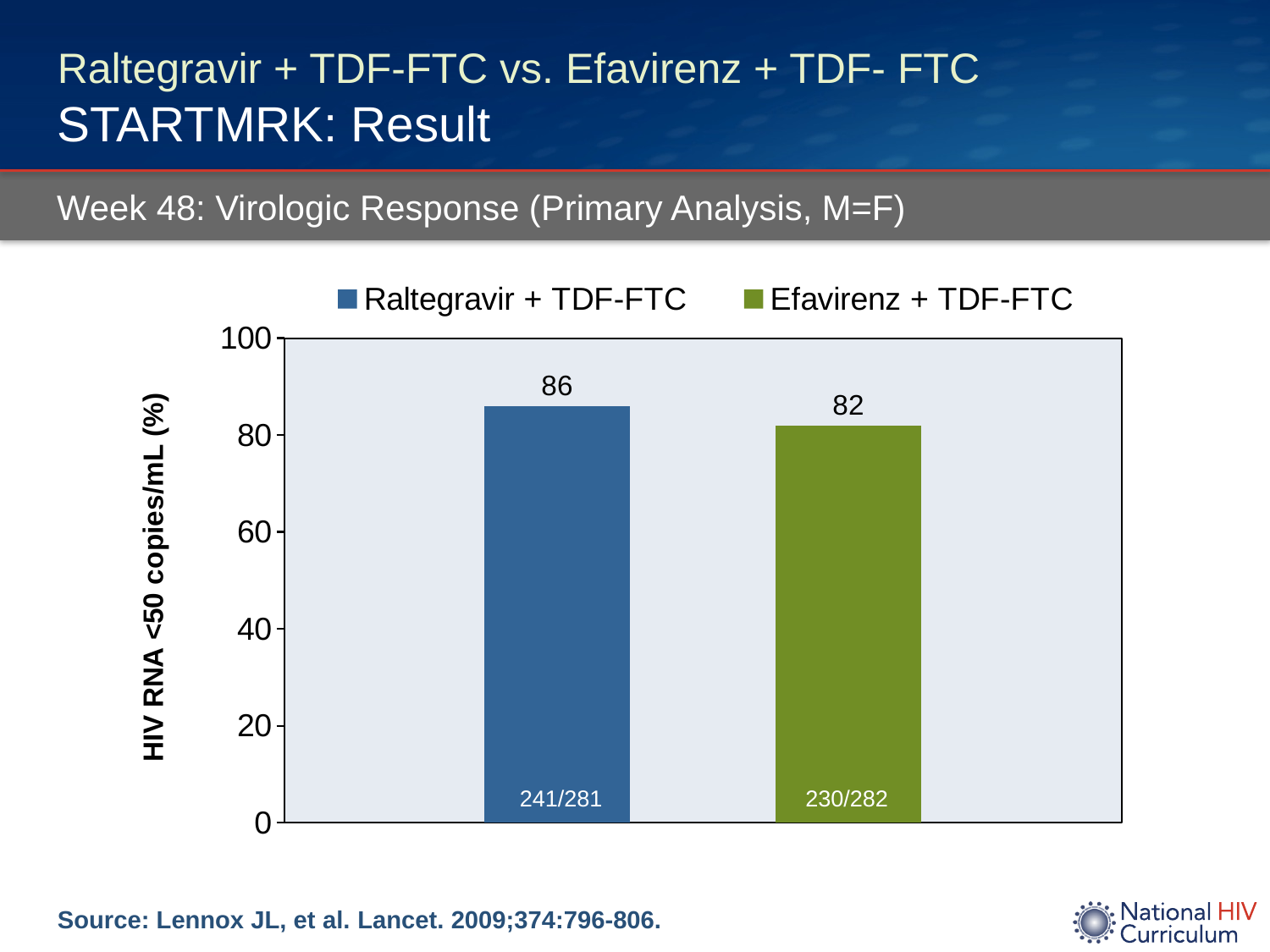
What is the difference between the Raltegravir + TDF-FTC value and the Efavirenz + TDF-FTC value? 4 What is the value for Efavirenz + TDF-FTC? 82 What is the label of the y axis? HIV RNA <50 copies/mL (%) What is the value for Raltegravir + TDF-FTC? 86 What kind of chart is shown? bar chart Which series has the lower value? Efavirenz + TDF-FTC Is the value for Raltegravir + TDF-FTC greater or less than 100? less Is the value for Efavirenz + TDF-FTC greater or less than 80? greater What fraction is printed inside the Raltegravir + TDF-FTC bar? 241/281 How many series does the legend list? 2 Which series has the higher value? Raltegravir + TDF-FTC How many bars are plotted in the chart? 2